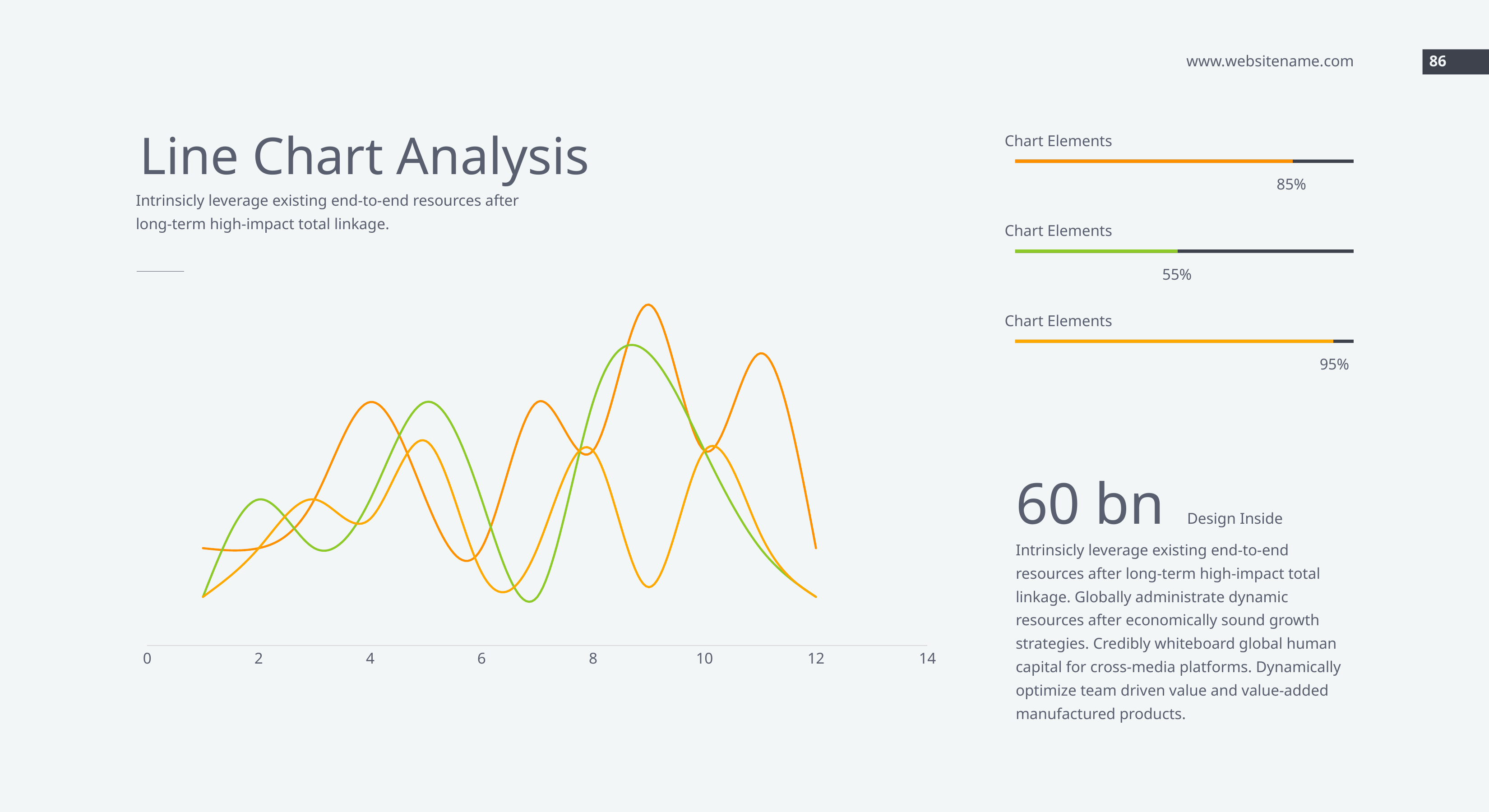
What is the spacing between consecutive x-axis tick labels on the line chart? 2 What is the title of the slide containing the line chart? Line Chart Analysis What is the highest tick label shown on the x axis of the line chart? 14 How many tick labels are shown on the x axis of the line chart? 8 How many lines are plotted on the line chart? 3 At which x-axis value do the plotted lines end? 12 What is the lowest tick label shown on the x axis of the line chart? 0 Between which two x-axis tick labels does the highest peak of any line occur? 8 and 10 Does the line chart include a legend? No What kind of chart is shown on the slide? Line chart Do the lines on the chart rise steadily, fall steadily, or fluctuate up and down along the x axis? Fluctuate up and down